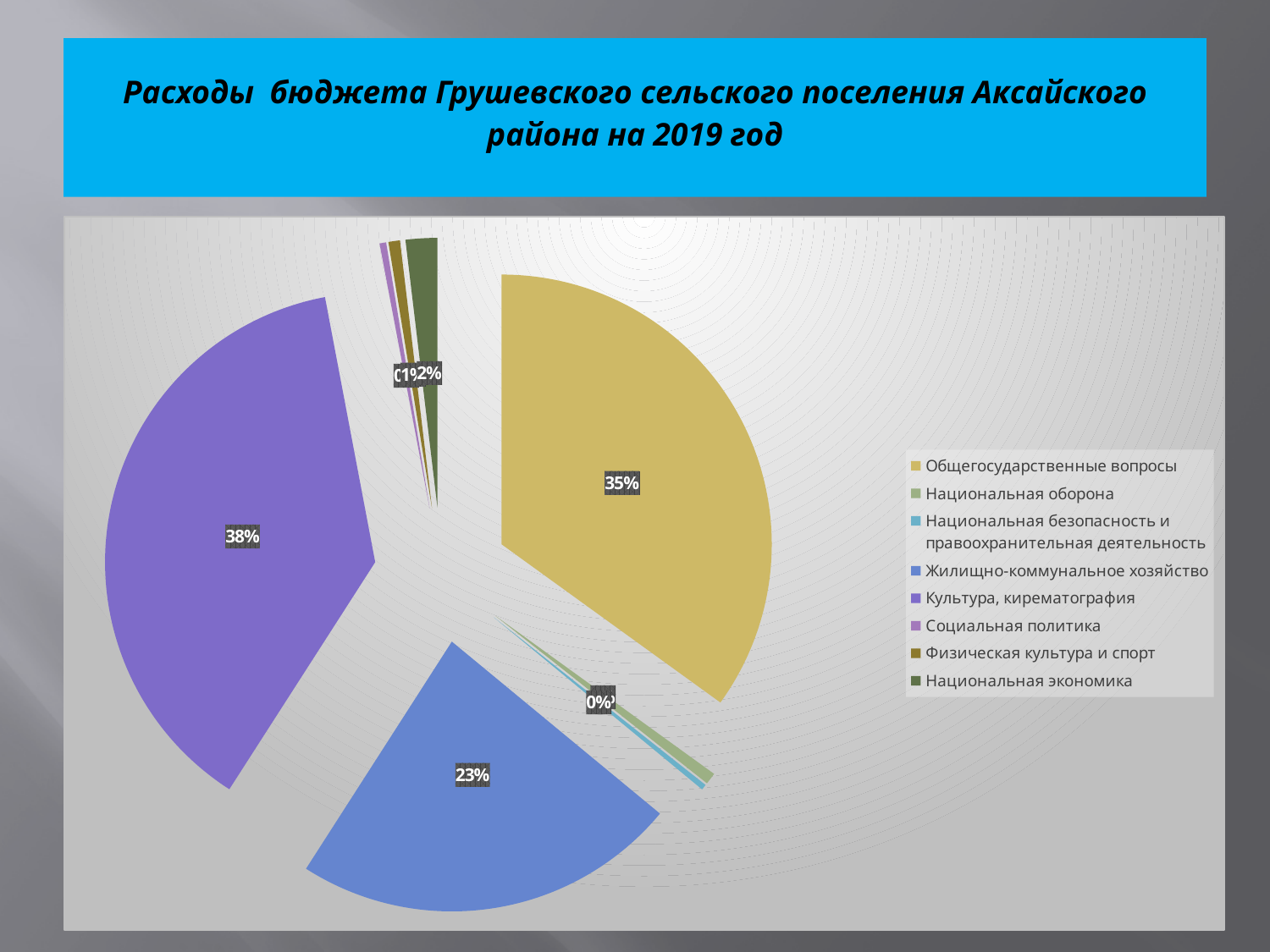
What share of the budget expenses goes to Общегосударственные вопросы? 35% By how many percentage points does the share for Общегосударственные вопросы exceed the share for Жилищно-коммунальное хозяйство? 12 percentage points What share of the budget expenses goes to Культура, кинематография? 38% What kind of chart is shown on the slide? Pie chart Which is larger: the share for Общегосударственные вопросы or the share for Жилищно-коммунальное хозяйство? Общегосударственные вопросы Which category has the largest share of the budget expenses? Культура, кирематография How many categories does the legend of the pie chart list? 8 What is the title of the slide? Расходы бюджета Грушевского сельского поселения Аксайского района на 2019 год Which is larger: the share for Культура, кинематография or the share for Жилищно-коммунальное хозяйство? Культура, кирематография What colour is the slice for Общегосударственные вопросы? Yellow (gold) By how many percentage points does the share for Культура, кинематография exceed the share for Общегосударственные вопросы? 3 percentage points What share of the budget expenses goes to Жилищно-коммунальное хозяйство? 23%